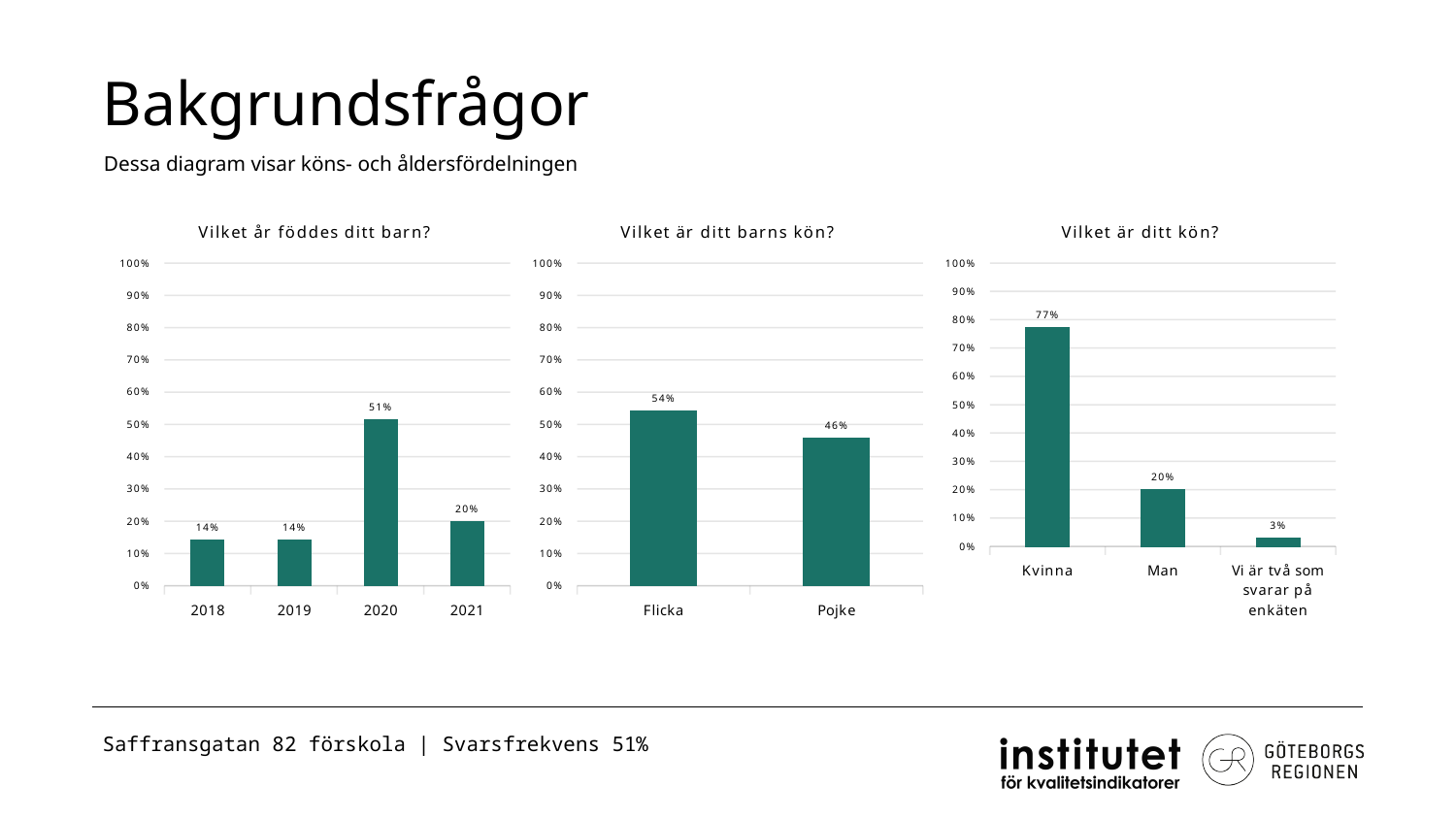
In the chart 'Vilket är ditt barns kön?', which category is larger, Flicka or Pojke? Flicka In the chart 'Vilket år föddes ditt barn?', what is the value for 2020? 51% In the chart 'Vilket är ditt kön?', which category has the lowest value? Vi är två som svarar på enkäten In the chart 'Vilket år föddes ditt barn?', which year has the highest value? 2020 In the chart 'Vilket är ditt barns kön?', what is the value for Pojke? 46% In the chart 'Vilket är ditt kön?', is the value for Man greater or less than 30%? less In the chart 'Vilket år föddes ditt barn?', how many years are shown on the x axis? 4 In the chart 'Vilket är ditt barns kön?', what is the difference between Flicka and Pojke? 8% How many charts are shown on the slide? 3 What kind of chart is 'Vilket är ditt kön?'? Bar chart In the chart 'Vilket är ditt kön?', what is the value for Kvinna? 77% In the chart 'Vilket år föddes ditt barn?', what is the difference between the values for 2020 and 2021? 31%